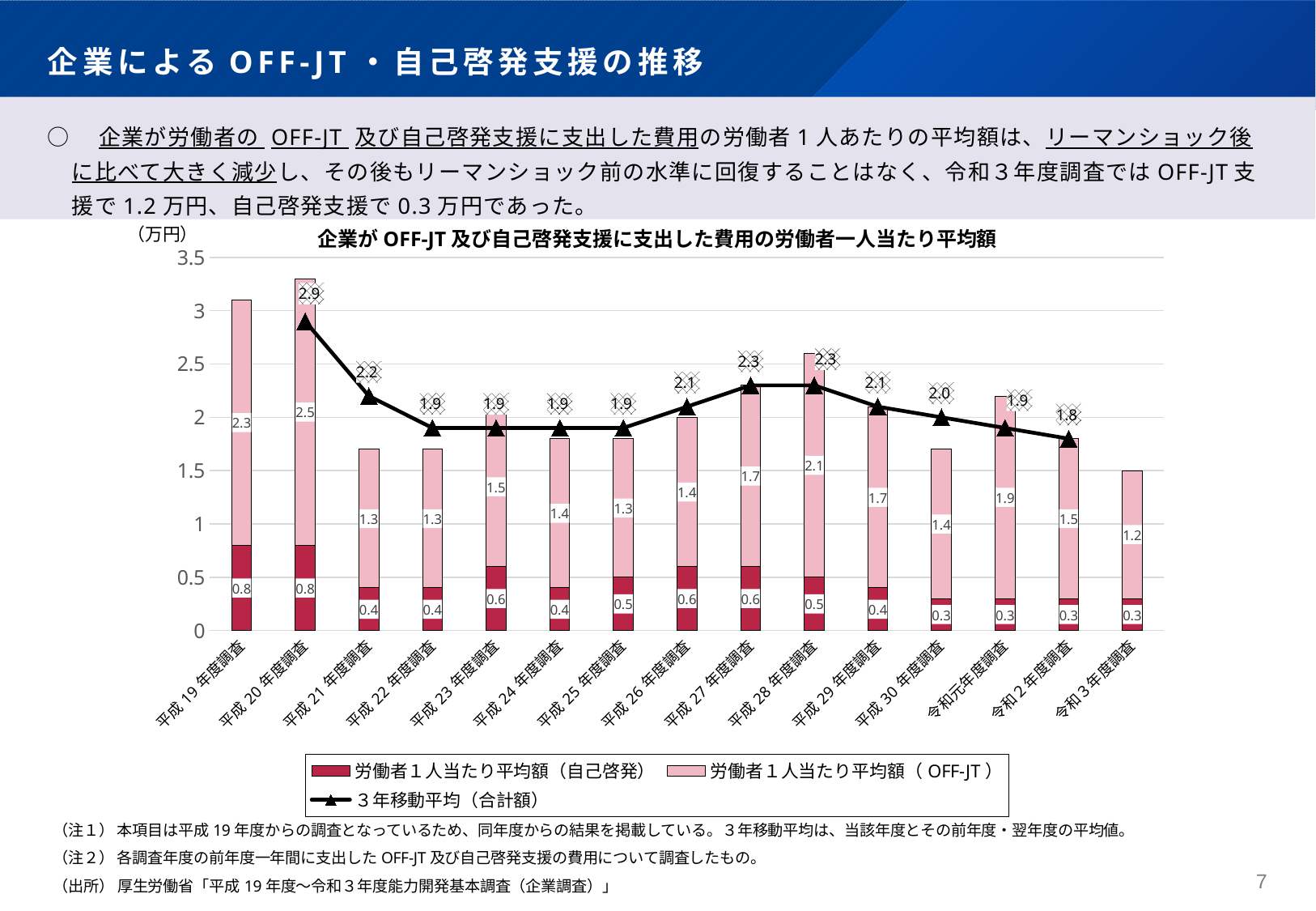
What is the difference between the OFF-JT values for 平成20年度調査 and 令和３年度調査? 1.3 What is the value for 労働者１人当たり平均額（OFF-JT） in 令和３年度調査? 1.2 Which is larger, the 自己啓発 value for 平成23年度調査 or for 平成30年度調査? 平成23年度調査 What kind of chart is this? Stacked bar chart with a line What is the total of the stacked bar for 平成28年度調査? 2.6 How many series does the legend list? 3 What is the value of the ３年移動平均（合計額） line at 平成20年度調査? 2.9 How many survey years are shown on the x axis? 15 What unit is shown at the top of the y axis? 万円 What is the value for 労働者１人当たり平均額（自己啓発） in 平成19年度調査? 0.8 Which survey year has the lowest value for 労働者１人当たり平均額（OFF-JT）? 令和３年度調査 Which survey year has the highest value for 労働者１人当たり平均額（OFF-JT）? 平成20年度調査